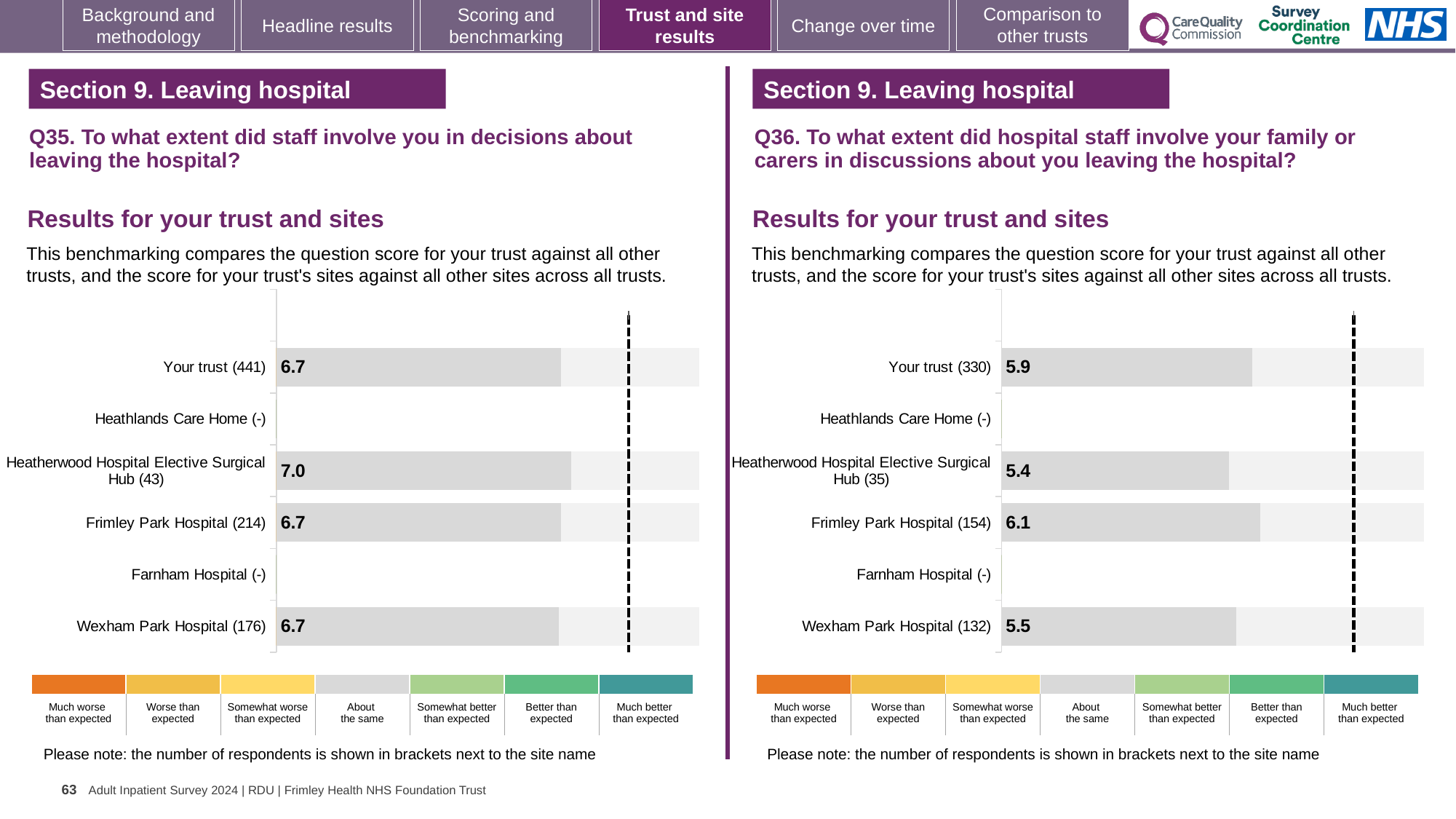
On the Q35 chart (left), what is the difference between the scores for Heatherwood Hospital Elective Surgical Hub and Your trust? 0.3 On the Q36 chart (right), which has the higher score, Frimley Park Hospital or Wexham Park Hospital? Frimley Park Hospital On the Q36 chart (right), which site has the lowest score? Heatherwood Hospital Elective Surgical Hub What kind of chart is used on the Q36 chart (right)? Bar chart How many site/trust categories are listed on the Q35 chart (left)? 6 On the Q36 chart (right), what is the score for Wexham Park Hospital? 5.5 On the Q35 chart (left), how many respondents are shown in brackets for Your trust? 441 On the Q35 chart (left), what is the score for Your trust? 6.7 On the Q35 chart (left), which site has the highest score? Heatherwood Hospital Elective Surgical Hub On the Q36 chart (right), what is the score for Frimley Park Hospital? 6.1 How many categories does the colour key below the Q36 chart (right) show? 7 On the Q36 chart (right), what is the difference between the scores for Frimley Park Hospital and Heatherwood Hospital Elective Surgical Hub? 0.7